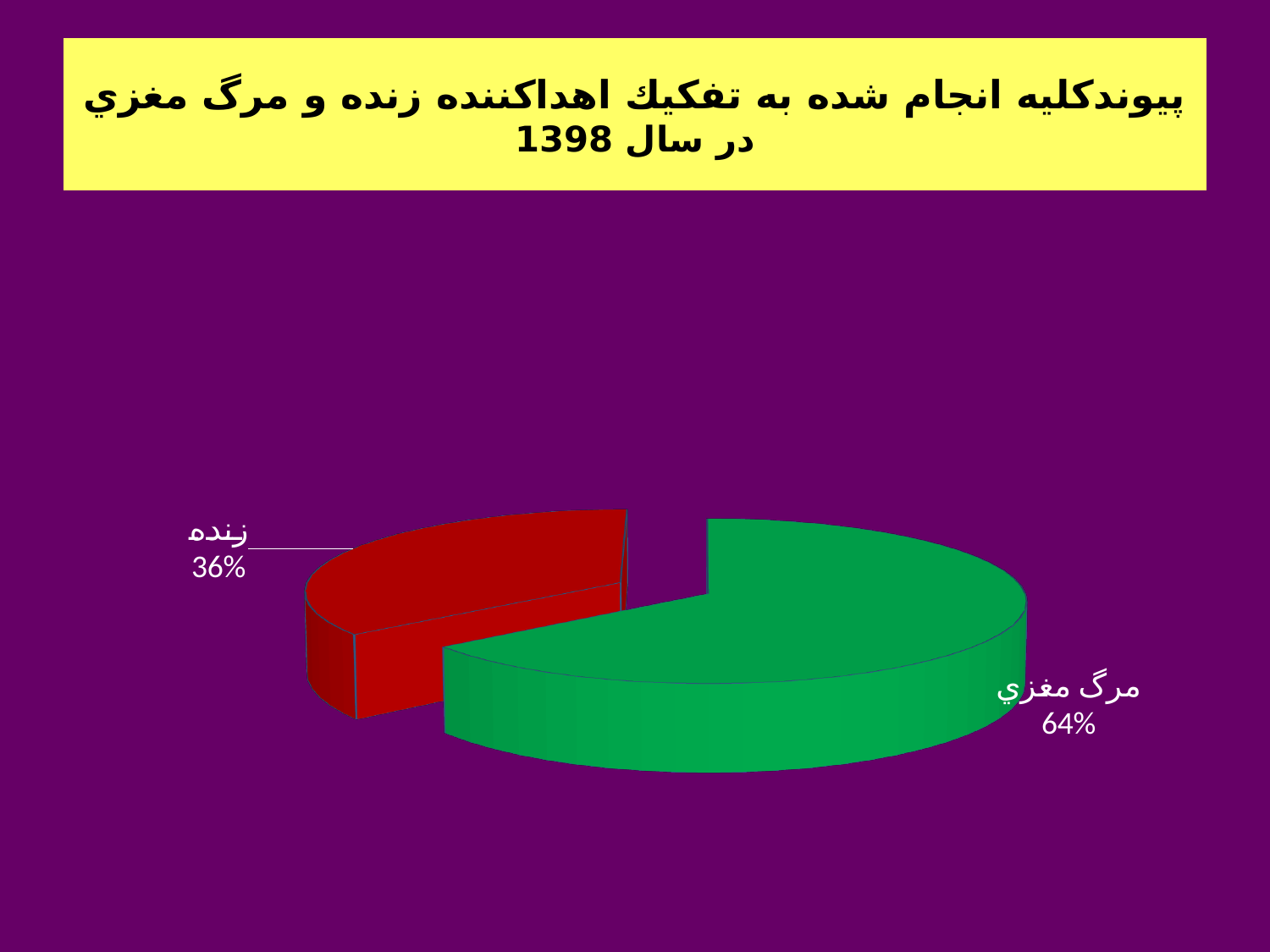
What share of the pie does the زنده (living donor) slice represent? 36% What kind of chart is shown on the slide? pie chart How many slices does the pie chart have? 2 What is the difference in percentage points between the مرگ مغزي slice and the زنده slice? 28% Which category has the largest share of the pie? مرگ مغزي What share of the pie does the مرگ مغزي (brain death) slice represent? 64% Which is larger, the share for زنده or the share for مرگ مغزي? مرگ مغزي Is the share for زنده greater or less than 50%? less What colour is the مرگ مغزي slice? green Which category has the smallest share of the pie? زنده What colour is the زنده slice? red